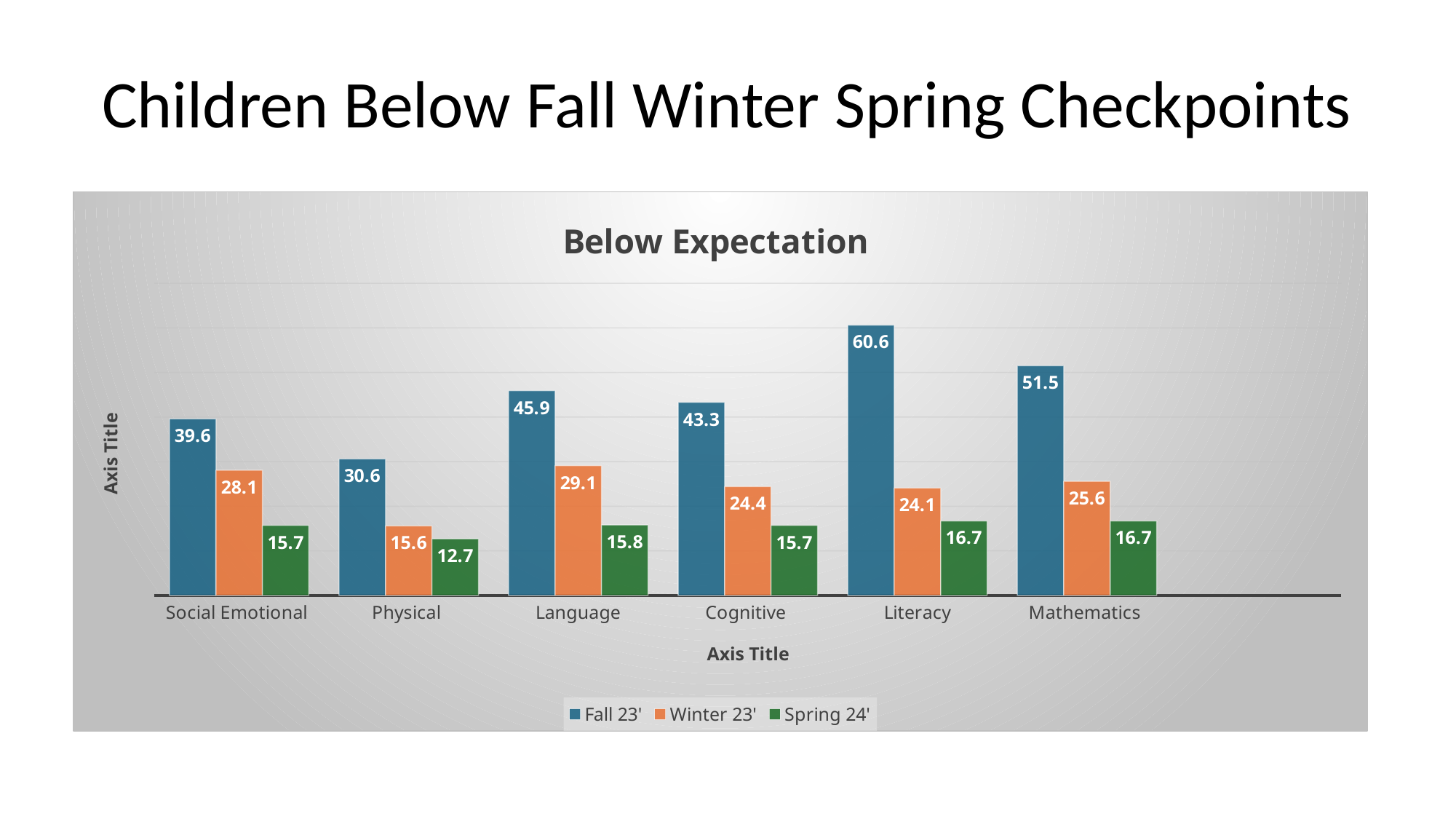
What is the title of the chart? Below Expectation How many series does the legend list? 3 What kind of chart is shown? Bar chart What is the Spring 24' value for Physical? 12.7 How many categories are shown on the x axis? 6 What is the Fall 23' value for Literacy? 60.6 Which category has the lowest Spring 24' value? Physical Which series is shown in green? Spring 24' Which is larger: the Winter 23' value for Social Emotional or the Winter 23' value for Language? Language Which category has the highest Fall 23' value? Literacy What is the Winter 23' value for Cognitive? 24.4 What is the difference between the Fall 23' and Spring 24' values for Mathematics? 34.8